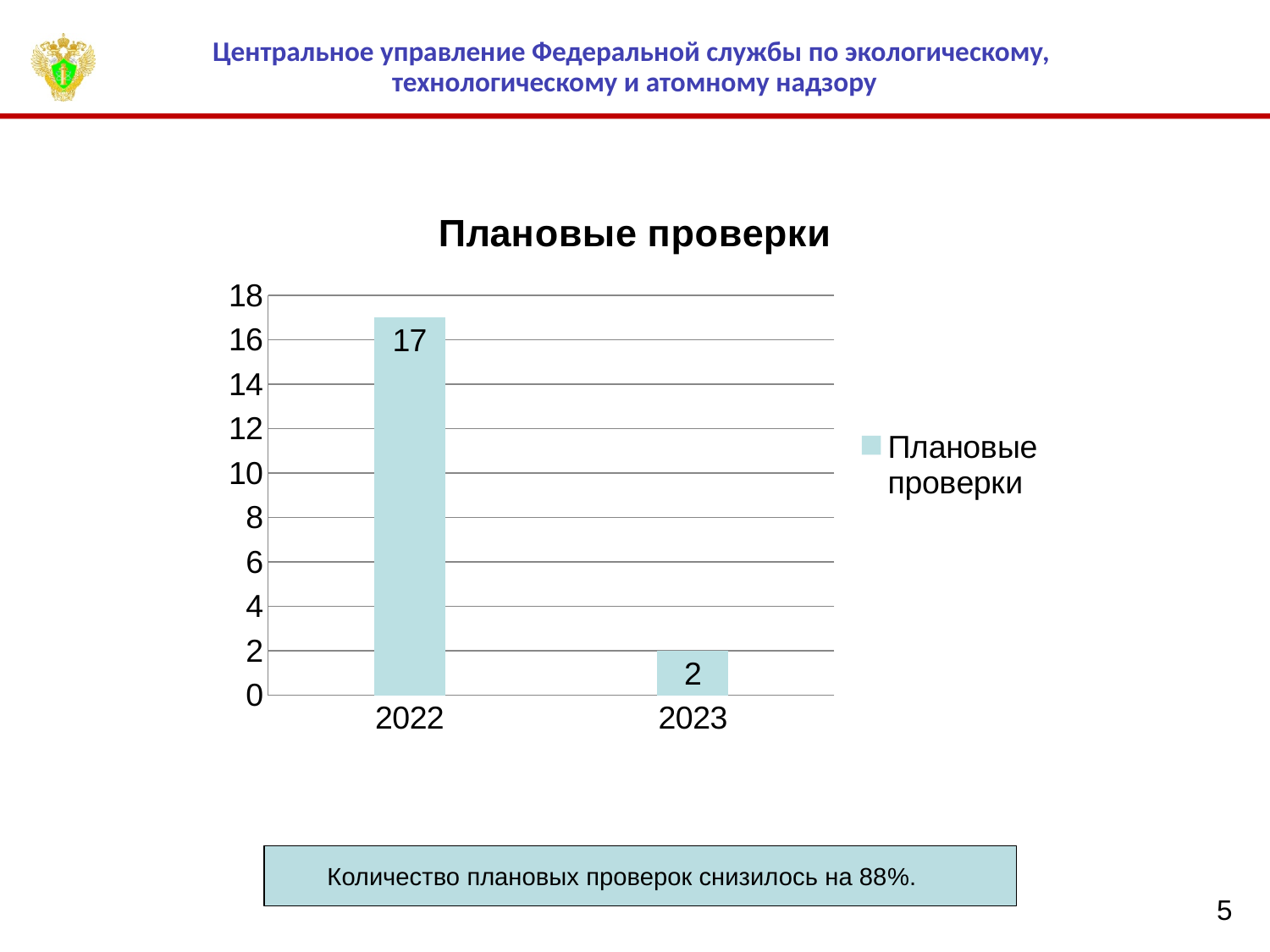
Is the value for 2023 greater or less than 4? less What kind of chart is shown on the slide? bar chart Which year has the highest value in the chart? 2022 Which is larger, the value for 2022 or the value for 2023? 2022 What is the value for 2022 in the chart? 17 Do the values rise or fall from 2022 to 2023? fall What is the difference between the values for 2022 and 2023? 15 How many series does the legend list? 1 How many categories are shown on the x axis of the chart? 2 Which year has the lowest value in the chart? 2023 Is the value for 2022 greater or less than 10? greater What is the value for 2023 in the chart? 2